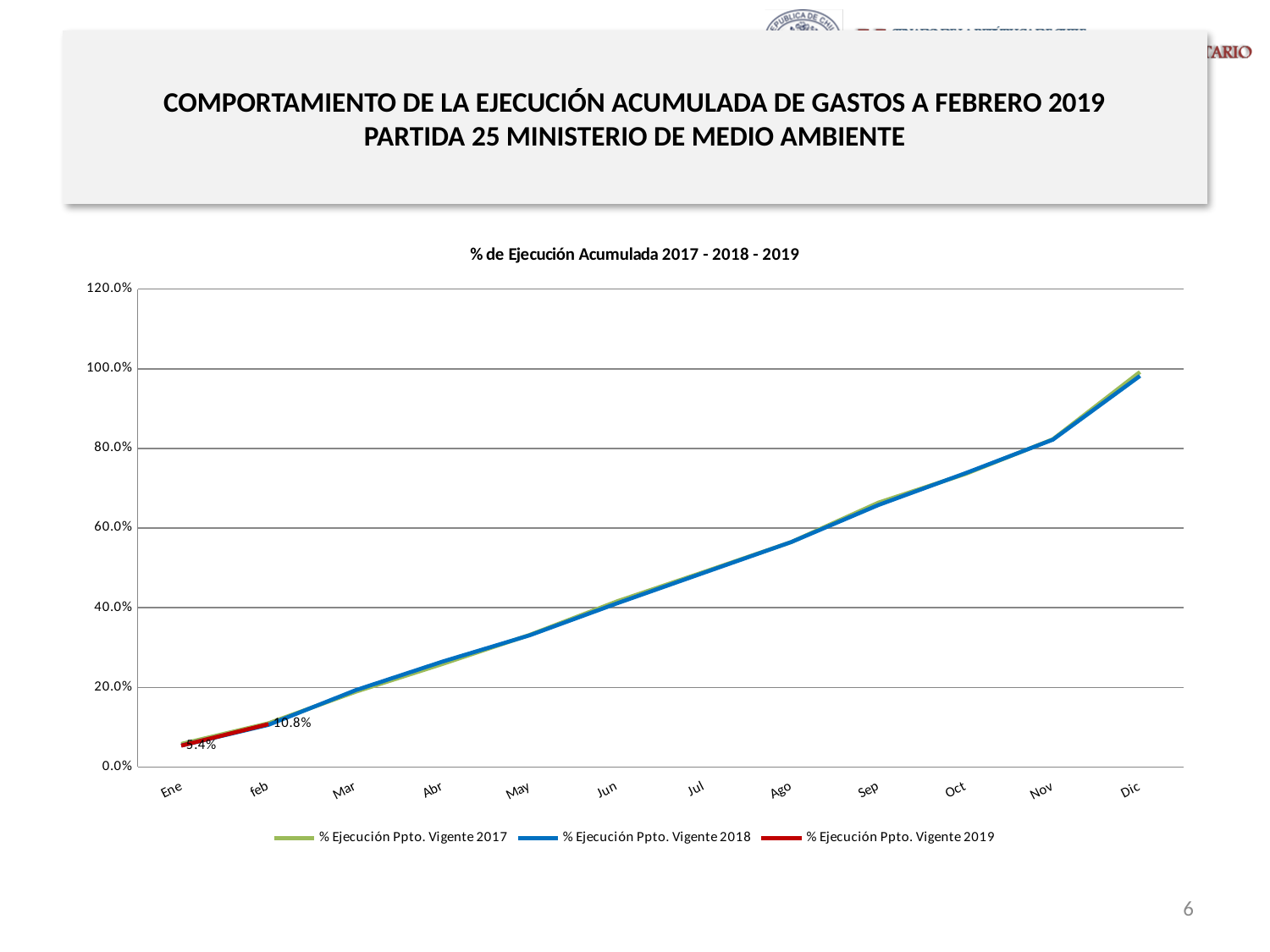
Which is larger for the 2019 series, the value for Ene or the value for feb? feb Is the value for % Ejecución Ppto. Vigente 2018 in Jun greater or less than 60%? less Is the value for % Ejecución Ppto. Vigente 2018 in Dic greater or less than 80%? greater In which month does % Ejecución Ppto. Vigente 2018 reach its highest value? Dic What is the title of the chart? % de Ejecución Acumulada 2017 - 2018 - 2019 How many series does the legend list? 3 What is the value of % Ejecución Ppto. Vigente 2019 for Ene? 5.4% What is the value of % Ejecución Ppto. Vigente 2019 for feb? 10.8% What kind of chart is shown on the slide? Line chart Do the values for % Ejecución Ppto. Vigente 2018 rise or fall from Ene to Dic? Rise What is the difference between the 2019 values for feb and Ene? 5.4% How many months are shown on the x axis? 12